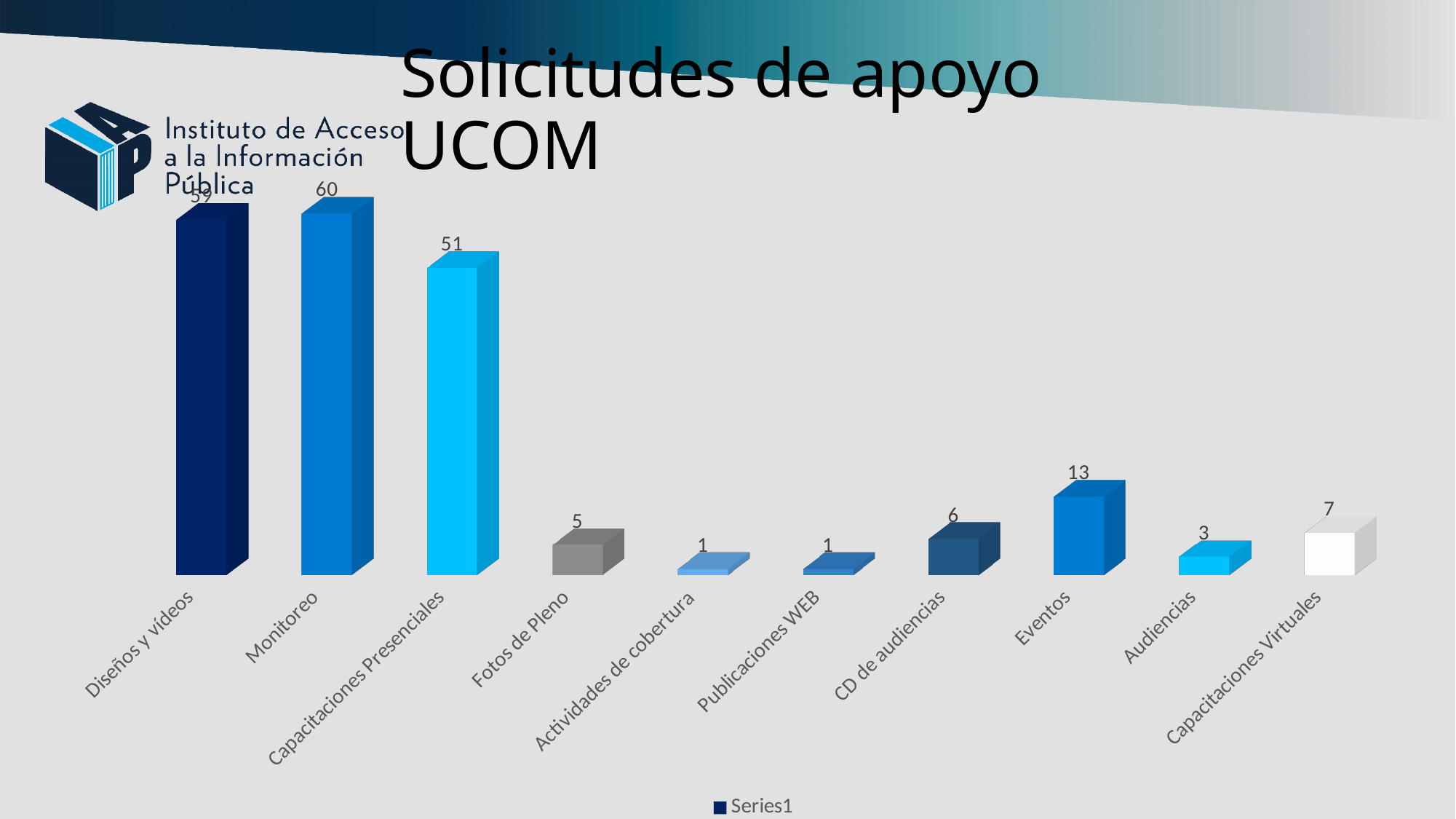
What is the title of the slide? Solicitudes de apoyo UCOM What is the value for Monitoreo? 60 What is the value for Fotos de Pleno? 5 Which is larger, the value for Capacitaciones Virtuales or the value for Audiencias? Capacitaciones Virtuales What kind of chart is shown on the slide? Bar chart What is the difference between the values for Eventos and CD de audiencias? 7 What is the value for Capacitaciones Presenciales? 51 What is the value for Capacitaciones Virtuales? 7 What is the difference between the values for Monitoreo and Capacitaciones Presenciales? 9 What is the value for Eventos? 13 Which category has the highest value? Monitoreo How many categories are shown in the chart? 10